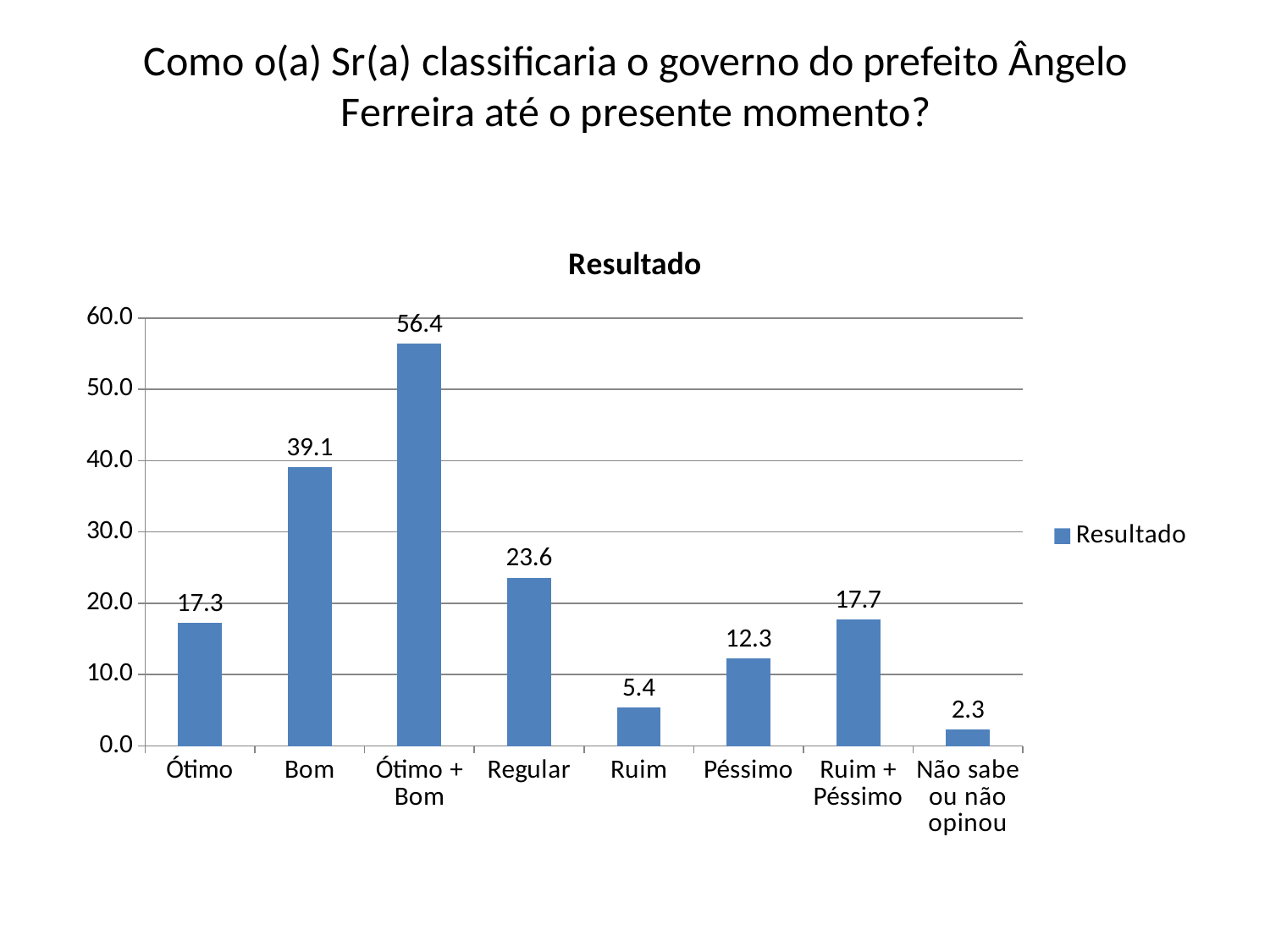
What is the value for Não sabe ou não opinou? 2.3 What is the value for Ótimo? 17.3 Which category has the highest value? Ótimo + Bom What kind of chart is shown? bar chart What is the title of the chart? Resultado Is the value for Ruim + Péssimo greater or less than 20.0? less How many categories are shown on the x axis? 8 Which is larger, the value for Péssimo or the value for Ruim? Péssimo How many series does the legend list? 1 Which category has the lowest value? Não sabe ou não opinou What is the value for Regular? 23.6 What is the difference between the values for Bom and Ótimo? 21.8